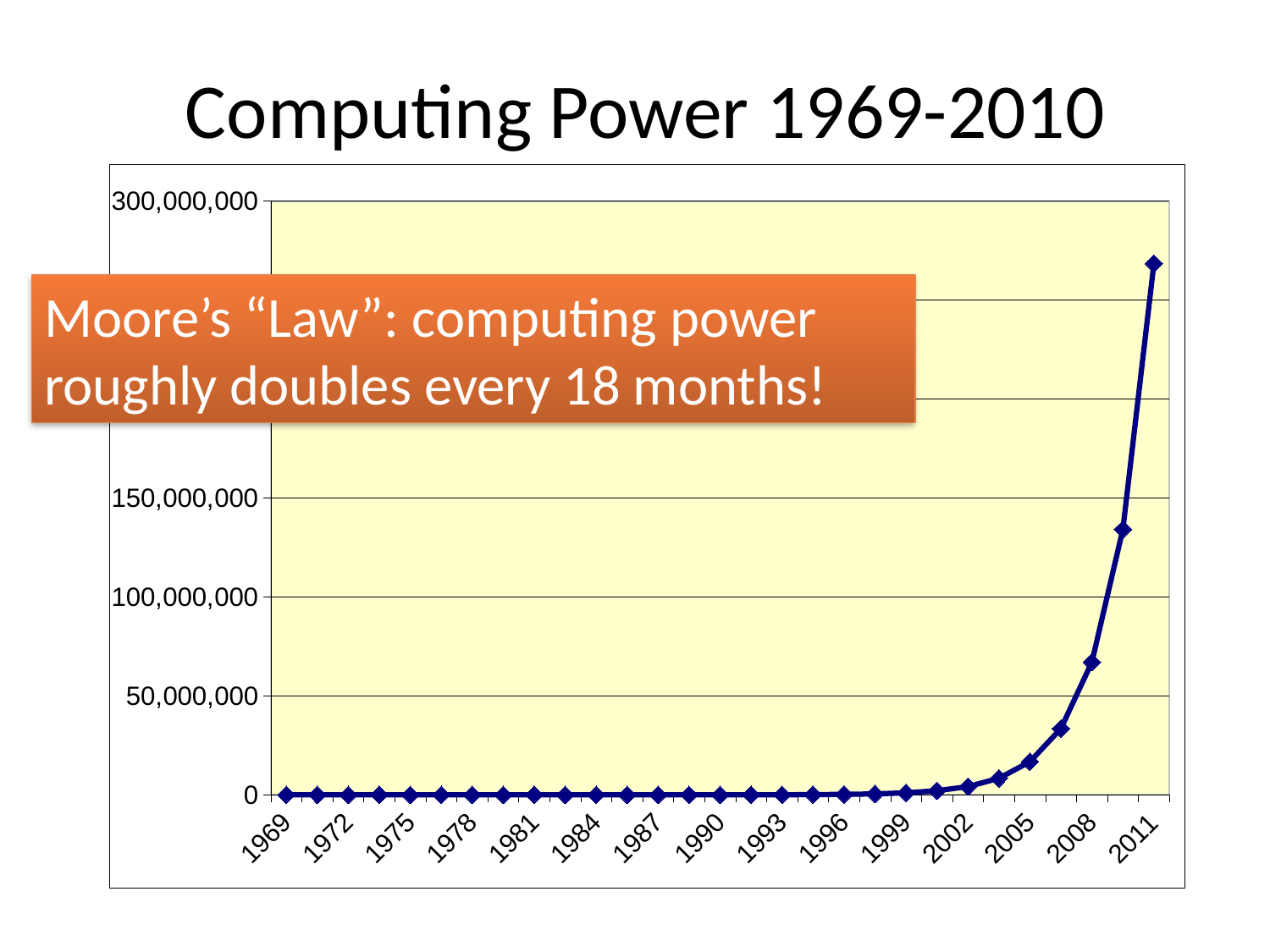
Which year has the highest computing power value on the chart? 2011 Do the values generally rise or fall from 1969 to 2011? rise What kind of chart is shown on the slide? line chart What is the highest value shown on the y axis? 300,000,000 Is the value for 2011 greater or less than 150,000,000? greater How many year labels are shown on the x axis? 15 Is the value for 2008 greater or less than 50,000,000? greater What is the title of the chart? Computing Power 1969-2010 Is the value for 2005 greater or less than 50,000,000? less